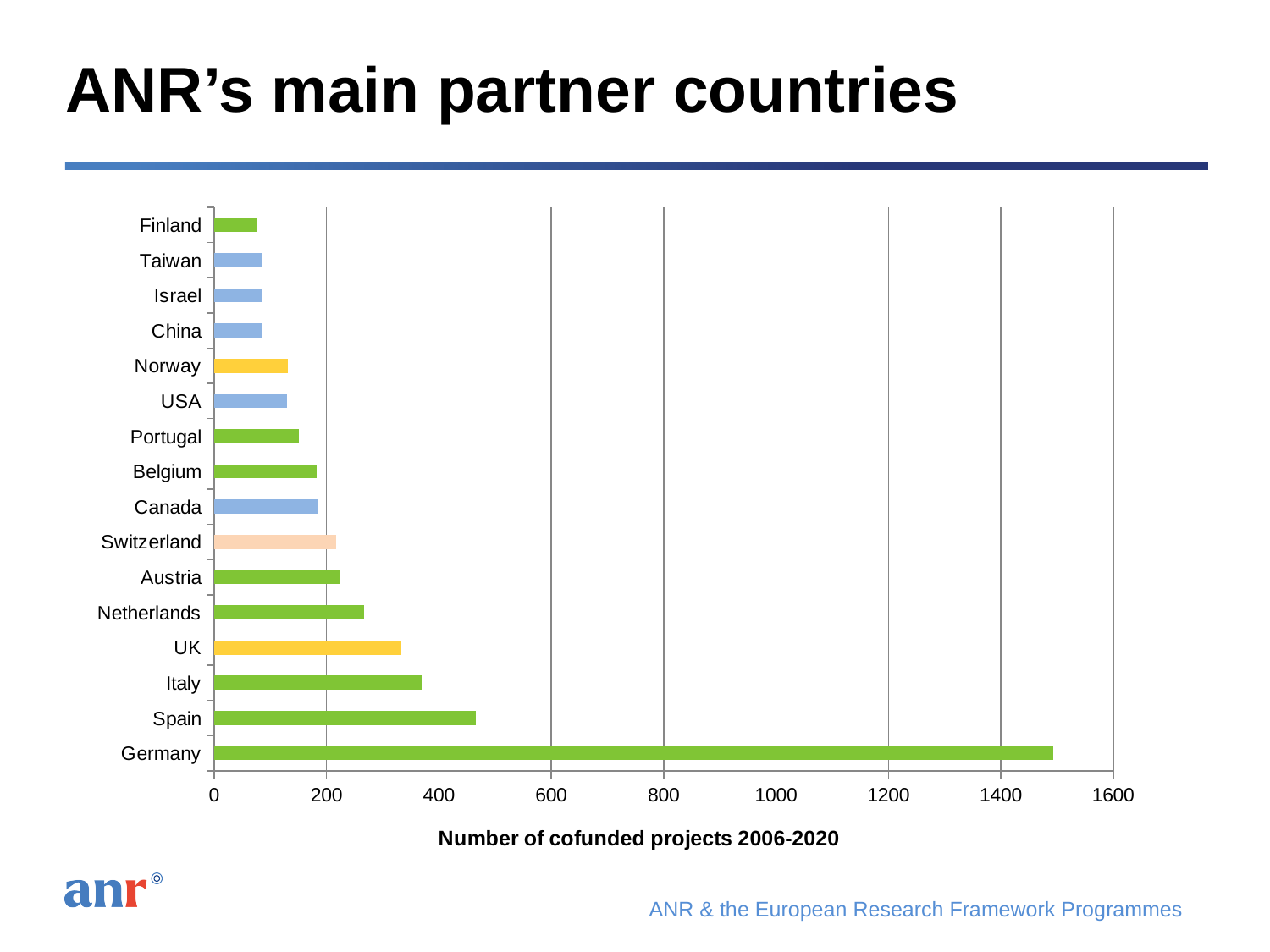
Is the value for the UK greater or less than 200? greater What kind of chart is shown on the slide? bar chart Is the value for Italy greater or less than 400? less Is the value for the USA greater or less than 200? less Which country has the highest number of cofunded projects? Germany How many countries are shown in the chart? 16 What is the label on the horizontal axis of the chart? Number of cofunded projects 2006-2020 Which has more cofunded projects, the UK or the Netherlands? UK Which has more cofunded projects, Spain or Italy? Spain